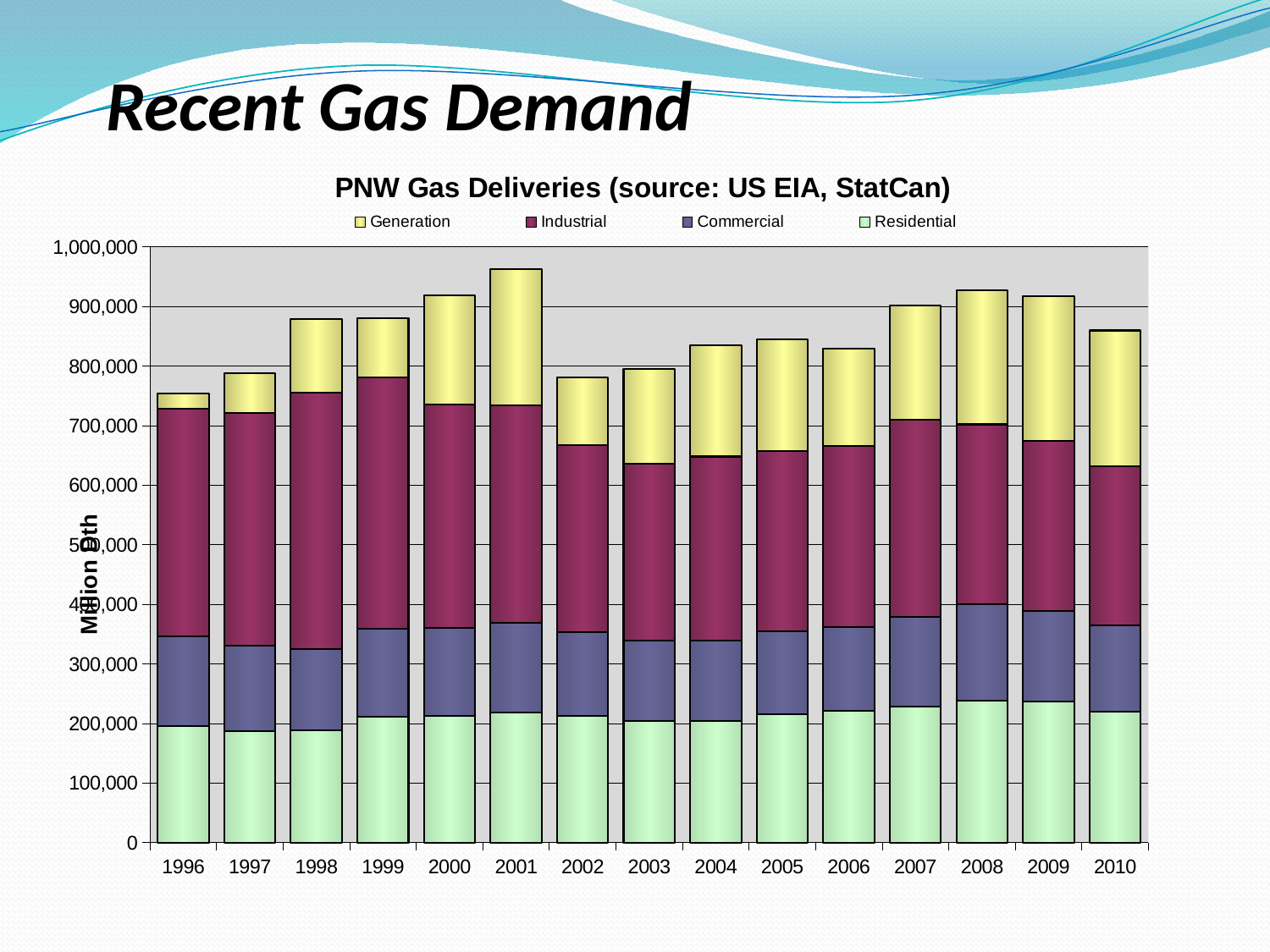
How many years are shown on the x axis? 15 Is the total for 2002 greater or less than 800,000? less What kind of chart is shown on the slide? Stacked bar chart Is the total for 1996 greater or less than 800,000? less Is the total for 2010 greater or less than 900,000? less How many series does the legend list? 4 Which year has the lowest total gas deliveries? 1996 Which series is shown in yellow at the top of each bar? Generation Which year has the highest total gas deliveries? 2001 Which year has the larger total, 2001 or 2002? 2001 What is the title of the chart? PNW Gas Deliveries (source: US EIA, StatCan)